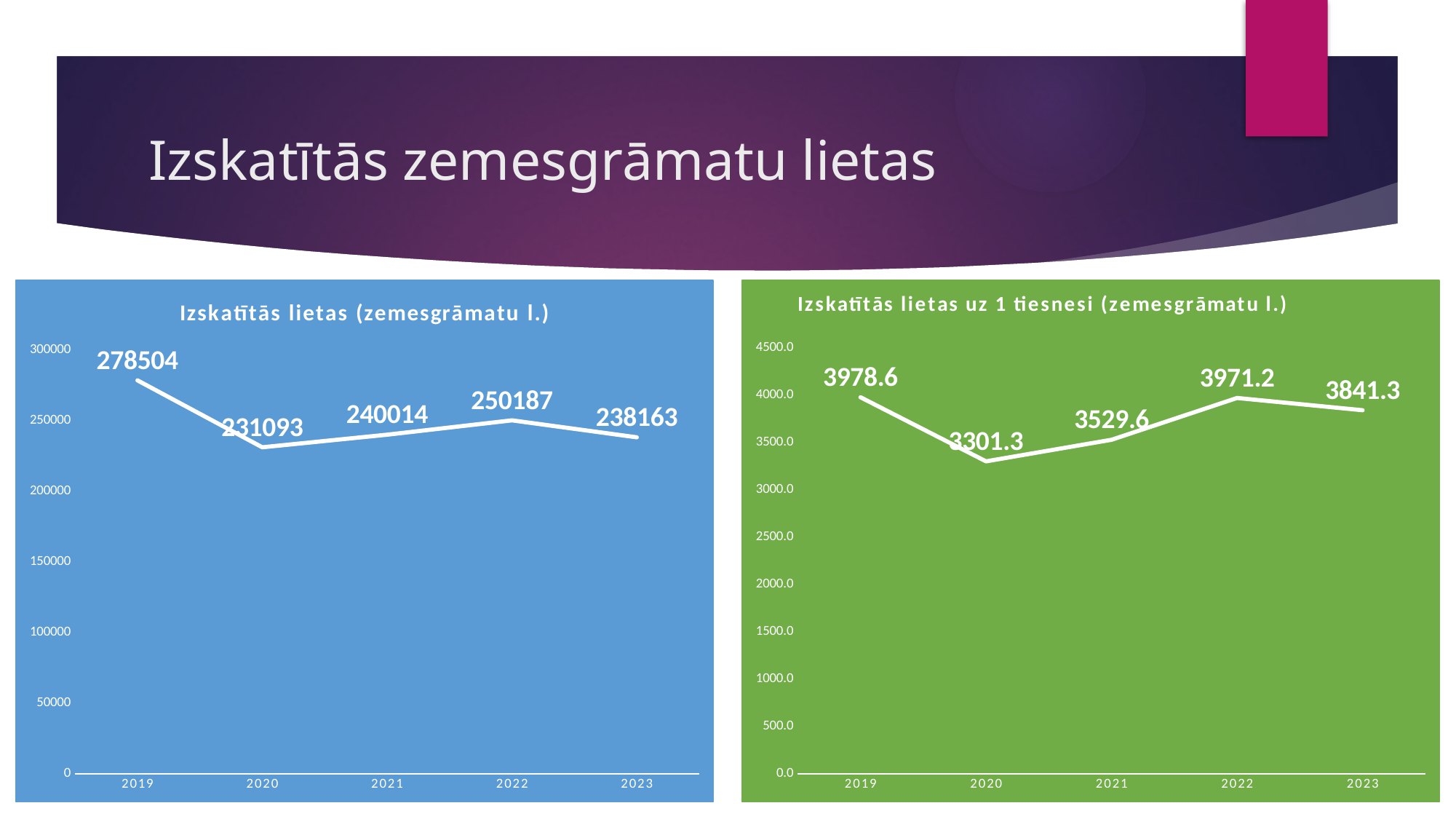
What is the title of the right chart on the slide? Izskatītās lietas uz 1 tiesnesi (zemesgrāmatu l.) In the right chart 'Izskatītās lietas uz 1 tiesnesi (zemesgrāmatu l.)', what is the difference between the 2022 and 2023 values? 129.9 In the left chart 'Izskatītās lietas (zemesgrāmatu l.)', what is the value for 2019? 278504 In the right chart 'Izskatītās lietas uz 1 tiesnesi (zemesgrāmatu l.)', does the value fall or rise from 2019 to 2020? fall In the right chart 'Izskatītās lietas uz 1 tiesnesi (zemesgrāmatu l.)', what is the value for 2021? 3529.6 In the right chart 'Izskatītās lietas uz 1 tiesnesi (zemesgrāmatu l.)', which year has the highest value? 2019 In the left chart 'Izskatītās lietas (zemesgrāmatu l.)', what is the value for 2022? 250187 What type of chart is the left chart 'Izskatītās lietas (zemesgrāmatu l.)'? line chart In the left chart 'Izskatītās lietas (zemesgrāmatu l.)', which year has the lowest value? 2020 In the left chart 'Izskatītās lietas (zemesgrāmatu l.)', what is the difference between the 2019 and 2020 values? 47411 How many years are plotted in the left chart 'Izskatītās lietas (zemesgrāmatu l.)'? 5 In the left chart 'Izskatītās lietas (zemesgrāmatu l.)', which is larger, the value for 2021 or the value for 2023? 2021